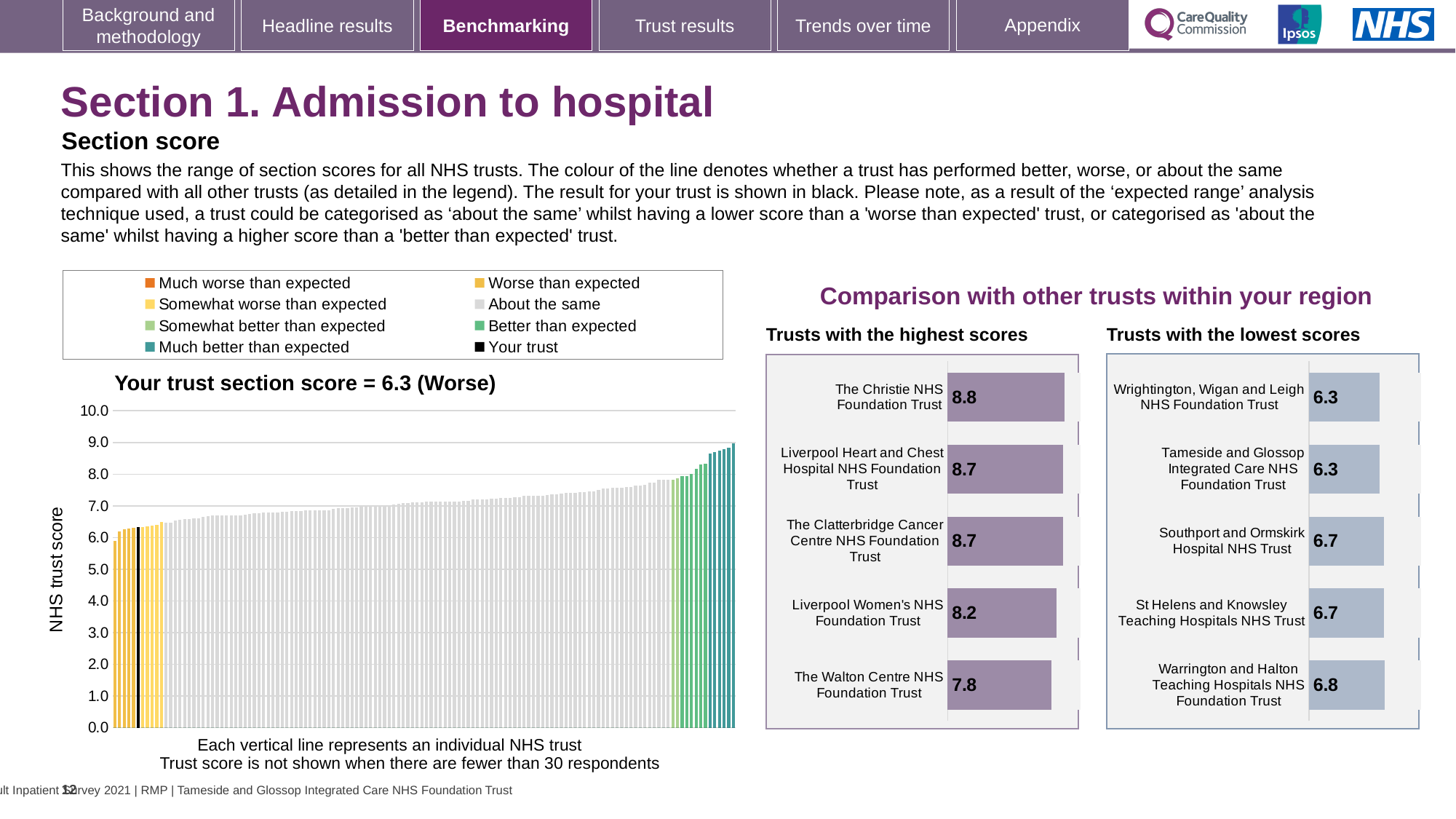
In the 'Trusts with the lowest scores' chart, what is the difference between the scores of Warrington and Halton Teaching Hospitals NHS Foundation Trust and Tameside and Glossop Integrated Care NHS Foundation Trust? 0.5 In the 'Trusts with the highest scores' chart, what is the score for The Christie NHS Foundation Trust? 8.8 How many entries does the legend above the 'Your trust section score' chart list? 8 In the 'Your trust section score' chart, do the trust scores rise or fall from left to right? rise In the 'Trusts with the lowest scores' chart, which has the larger score: Warrington and Halton Teaching Hospitals NHS Foundation Trust or Wrightington, Wigan and Leigh NHS Foundation Trust? Warrington and Halton Teaching Hospitals NHS Foundation Trust In the 'Trusts with the highest scores' chart, how many trusts are shown? 5 In the 'Your trust section score' chart, what is the section score for your trust? 6.3 In the 'Trusts with the highest scores' chart, which trust has the lowest score? The Walton Centre NHS Foundation Trust In the 'Trusts with the highest scores' chart, what is the difference between the scores of The Christie NHS Foundation Trust and The Walton Centre NHS Foundation Trust? 1.0 In the 'Trusts with the lowest scores' chart, what is the score for Southport and Ormskirk Hospital NHS Trust? 6.7 What kind of chart is the 'Your trust section score' chart? bar chart In the 'Trusts with the lowest scores' chart, which trust has the highest score? Warrington and Halton Teaching Hospitals NHS Foundation Trust